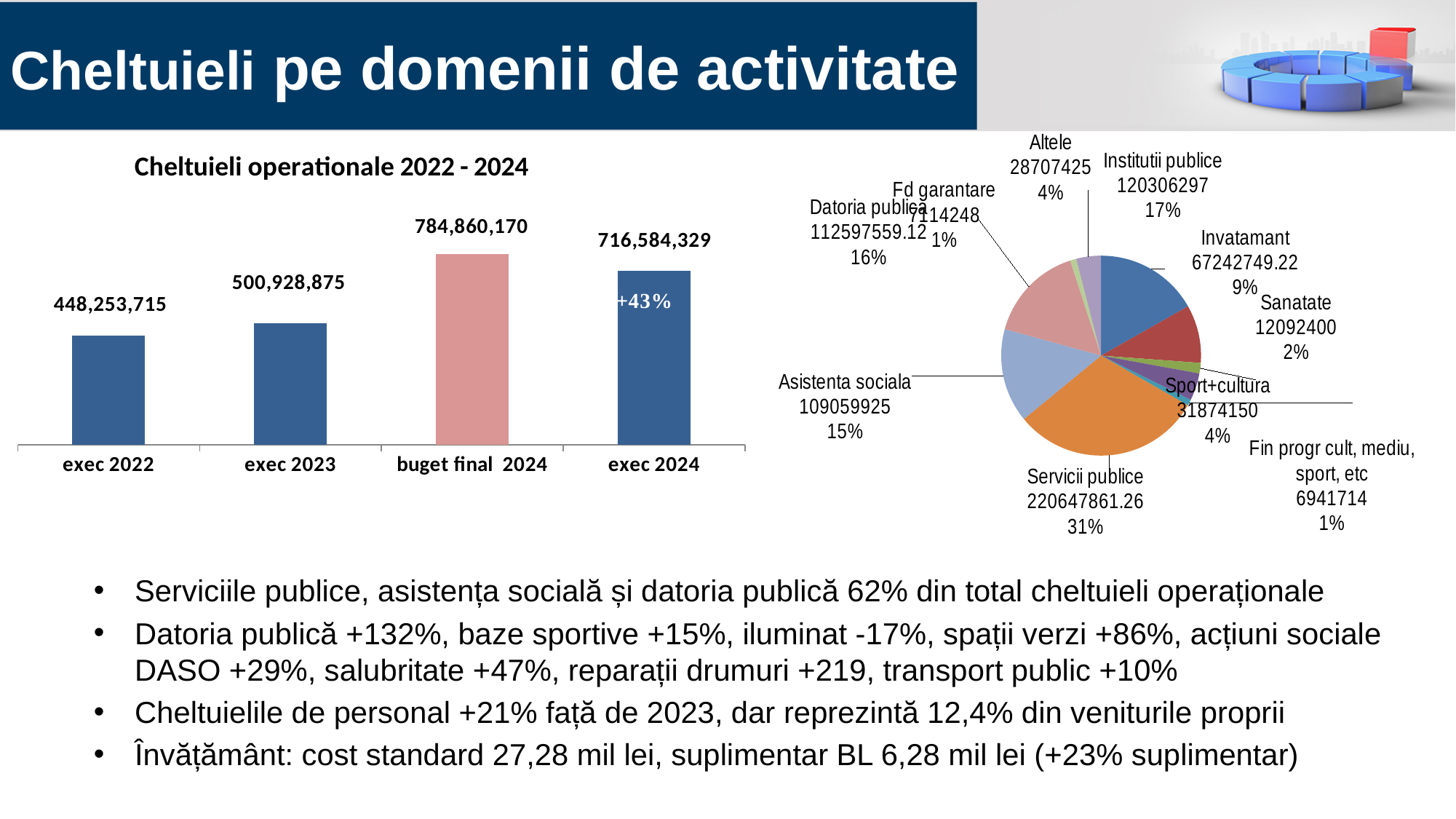
In the bar chart 'Cheltuieli operationale 2022 - 2024', how many bars are shown? 4 In the pie chart on the right, what share does Institutii publice represent? 17% In the bar chart 'Cheltuieli operationale 2022 - 2024', which category has the highest value? buget final 2024 In the bar chart 'Cheltuieli operationale 2022 - 2024', what is the value for exec 2022? 448,253,715 In the pie chart on the right, which category has the largest slice? Servicii publice In the pie chart on the right, which is larger: Asistenta sociala or Datoria publica? Datoria publica In the bar chart 'Cheltuieli operationale 2022 - 2024', which category has the lowest value? exec 2022 In the pie chart on the right, what is the value for Servicii publice? 220647861.26 In the bar chart 'Cheltuieli operationale 2022 - 2024', what is the difference between buget final 2024 and exec 2024? 68,275,841 In the bar chart 'Cheltuieli operationale 2022 - 2024', what is the value for buget final 2024? 784,860,170 What type of chart is the one on the right side of the slide? pie chart In the bar chart 'Cheltuieli operationale 2022 - 2024', what percentage change is labelled on the exec 2024 bar? +43%